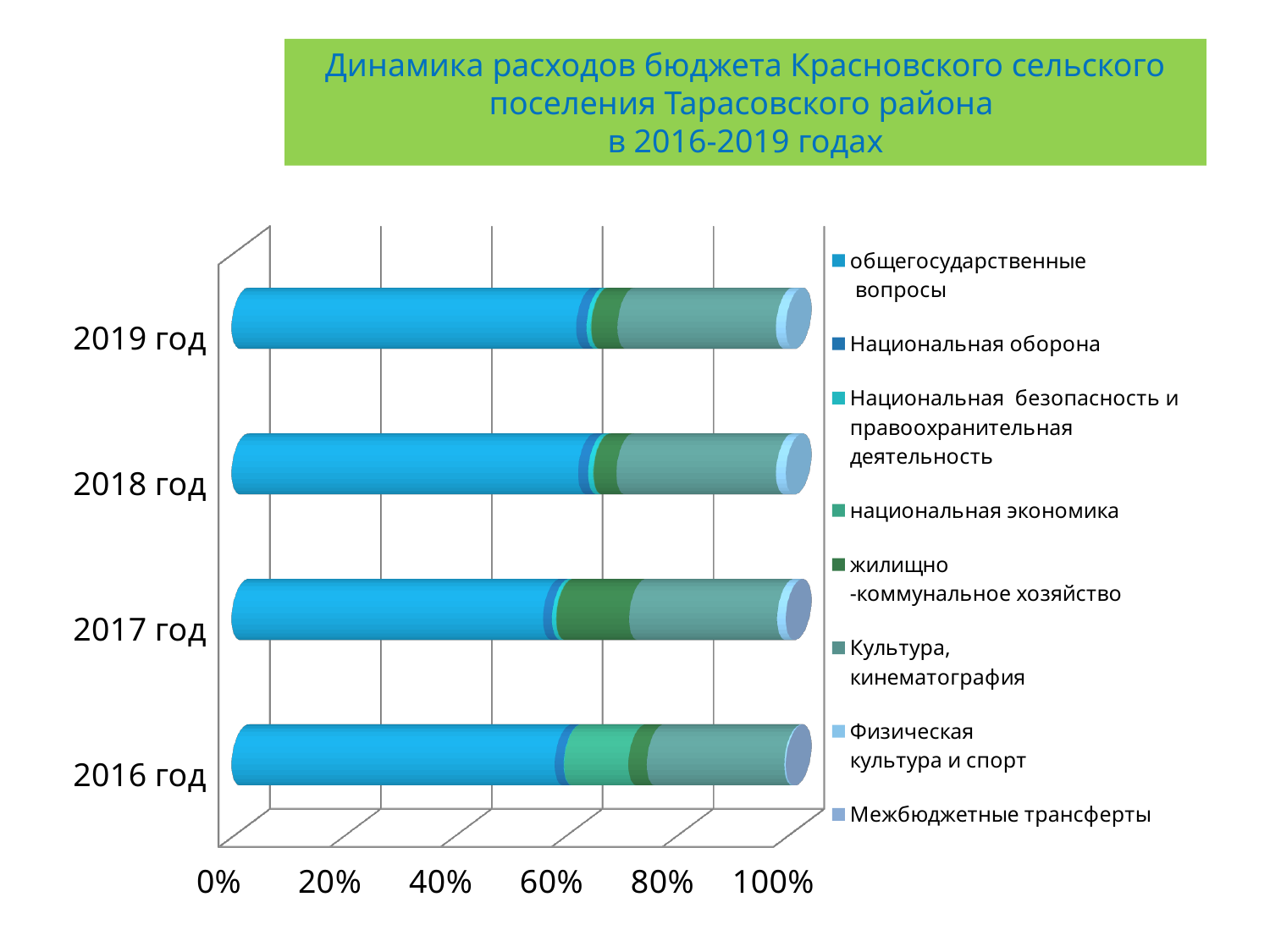
Is the share of 'общегосударственные вопросы' in 2017 год greater or less than 40%? greater What is the highest value shown on the horizontal axis? 100% Is the 'жилищно-коммунальное хозяйство' segment larger in 2017 год or in 2019 год? 2017 год How many series does the legend list? 8 In which year does the 'национальная экономика' segment visibly appear in the bar? 2016 год Is the 'общегосударственные вопросы' segment larger in 2019 год or in 2017 год? 2019 год What kind of chart is shown on the slide? Stacked bar chart Which year has the largest segment for 'жилищно-коммунальное хозяйство'? 2017 год How many years (categories) are plotted on the chart? 4 Which years are shown on the vertical axis of the chart? 2016 год, 2017 год, 2018 год, 2019 год Is the share of 'общегосударственные вопросы' in 2018 год greater or less than 80%? less